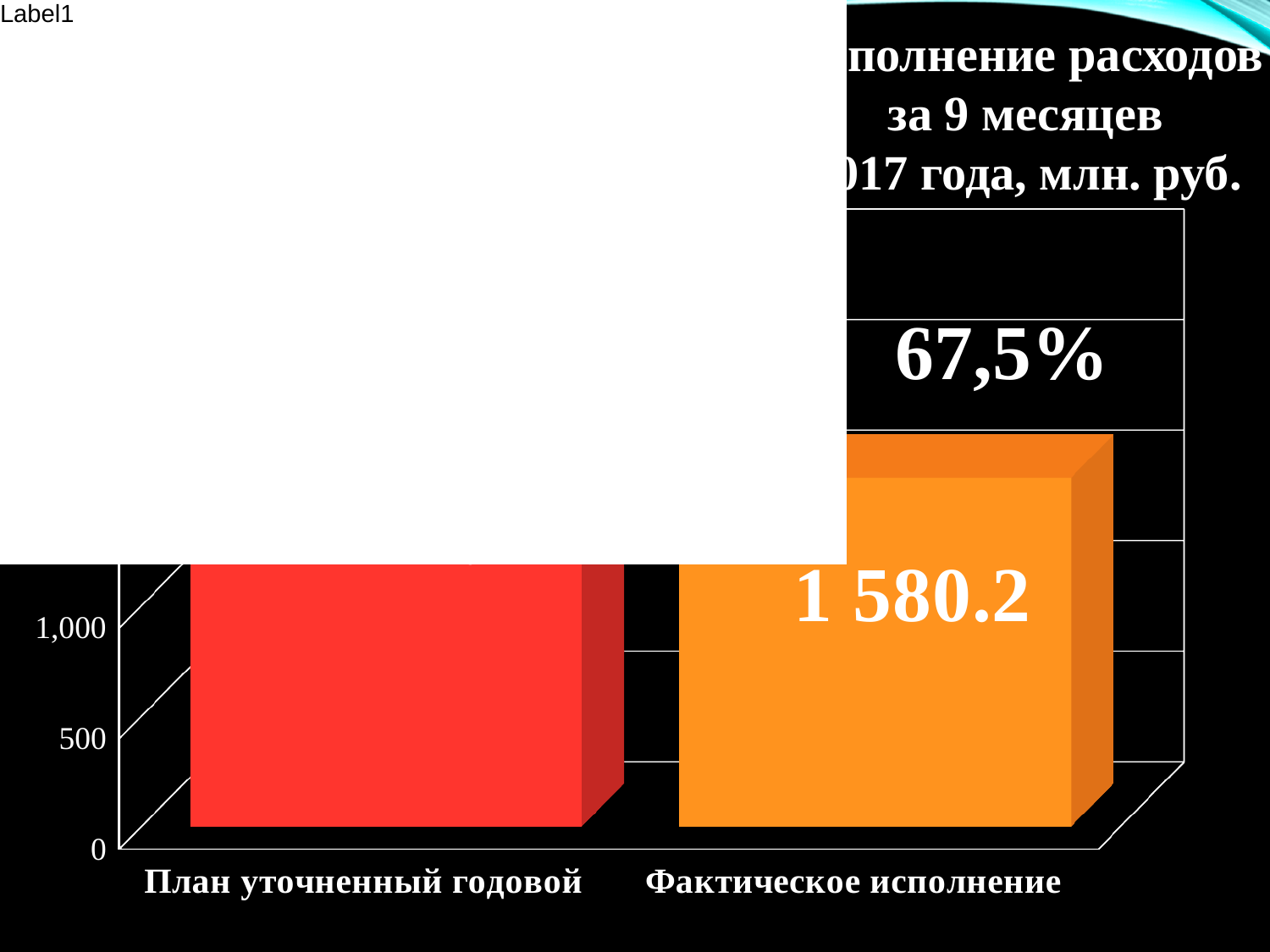
Is the value for План уточненный годовой greater or less than 1,000? greater What colour is the bar for Фактическое исполнение? orange What is the label of the left-hand bar on the chart? План уточненный годовой Is the value for Фактическое исполнение greater or less than 1,000? greater Is the value for План уточненный годовой greater or less than 500? greater What is the value shown for Фактическое исполнение? 1 580.2 How many categories are plotted on the chart? 2 What kind of chart is shown on the slide? bar chart What percentage figure is displayed on the slide above the Фактическое исполнение bar? 67,5%